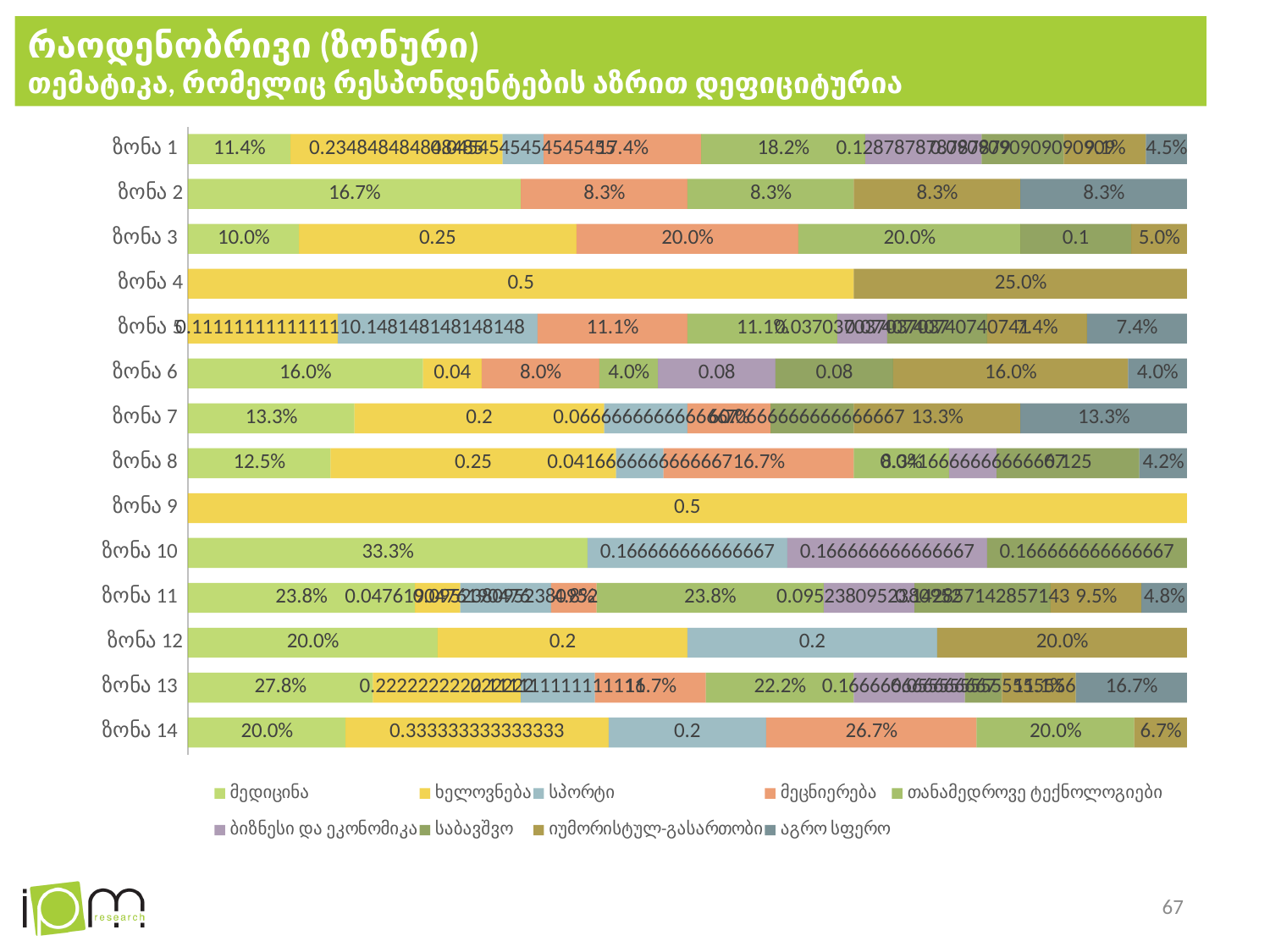
What is the value of მედიცინა for ზონა 3? 10.0% What type of chart is shown on the slide? stacked bar chart How many zones (ზონა) are listed on the vertical axis of the chart? 14 What is the first entry in the chart legend? მედიცინა How many series does the chart legend list? 9 Which zone has the highest value for მედიცინა? ზონა 10 What is the value of იუმორისტულ-გასართობი for ზონა 4? 25.0% Which is larger: the მედიცინა value for ზონა 10 or for ზონა 2? ზონა 10 What is the value of მედიცინა for ზონა 2? 16.7% What is the value of მეცნიერება for ზონა 14? 26.7% What is the value of მედიცინა for ზონა 10? 33.3% What is the value of მეცნიერება for ზონა 6? 8.0%